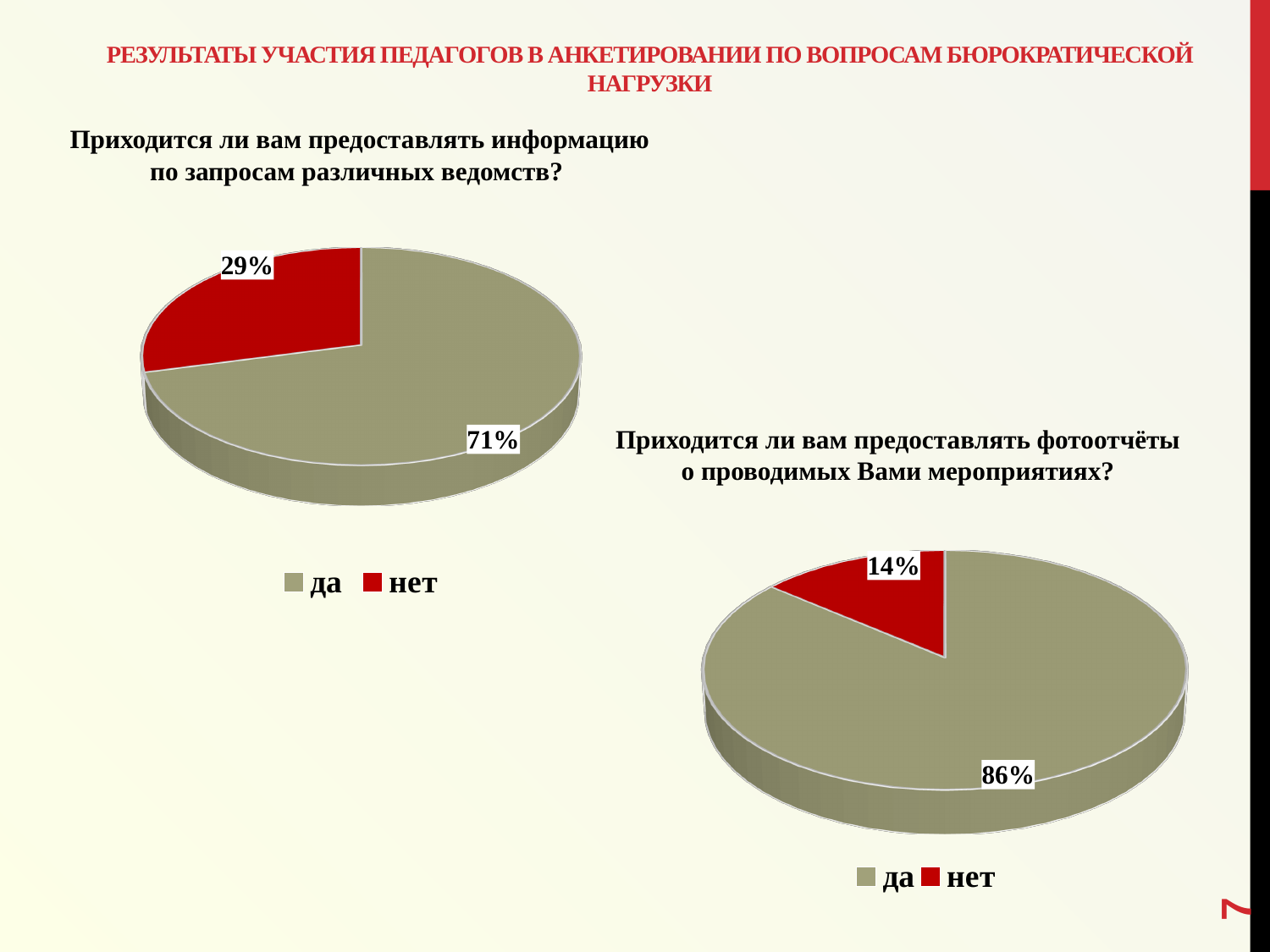
What type of chart is used on the left of the slide? pie chart In the right pie chart, what colour is the "нет" slice? red In the right pie chart, what is the difference between the "да" and "нет" shares? 72% In the left pie chart, what is the difference between the "да" and "нет" shares? 42% In the left pie chart, which answer has the largest slice? да In the right pie chart (about providing photo reports of events), what share of respondents answered "да"? 86% Which chart has the larger "нет" share, the left pie chart or the right pie chart? the left pie chart In the right pie chart, which answer has the smallest slice? нет In the right pie chart (about providing photo reports of events), what share of respondents answered "нет"? 14% How many categories does the legend of the right pie chart list? 2 In the left pie chart (about providing information on requests from various agencies), what share of respondents answered "да"? 71% In the left pie chart (about providing information on requests from various agencies), what share of respondents answered "нет"? 29%